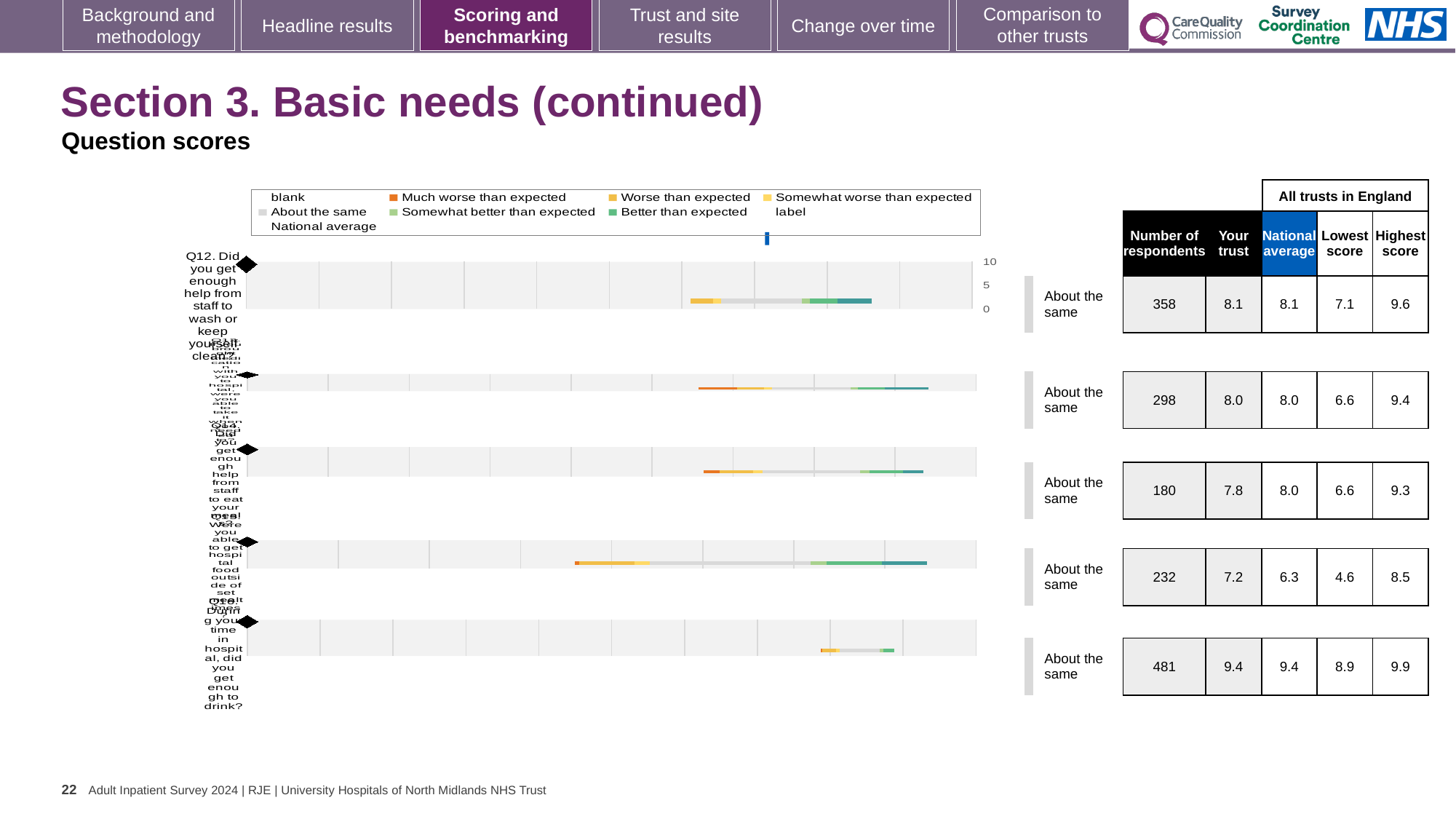
How many entries does the chart legend list? 9 What is the lowest score among all trusts in England for Q12? 7.1 What benchmark category is shown next to the Q12 bar? About the same What is the national average score for Q12? 8.1 What kind of chart is shown on the slide? bar chart What is the lowest 'Your trust' score shown in the table? 7.2 What is the number of respondents for Q12 (help from staff to wash or keep yourself clean)? 358 What is the difference between the highest score (9.6) and the lowest score (7.1) for Q12? 2.5 What is the highest 'Your trust' score shown in the table? 9.4 What colour does the legend use for 'Much worse than expected'? orange What is the 'Your trust' score for Q12? 8.1 How many question rows (bars) are plotted in the chart? 5